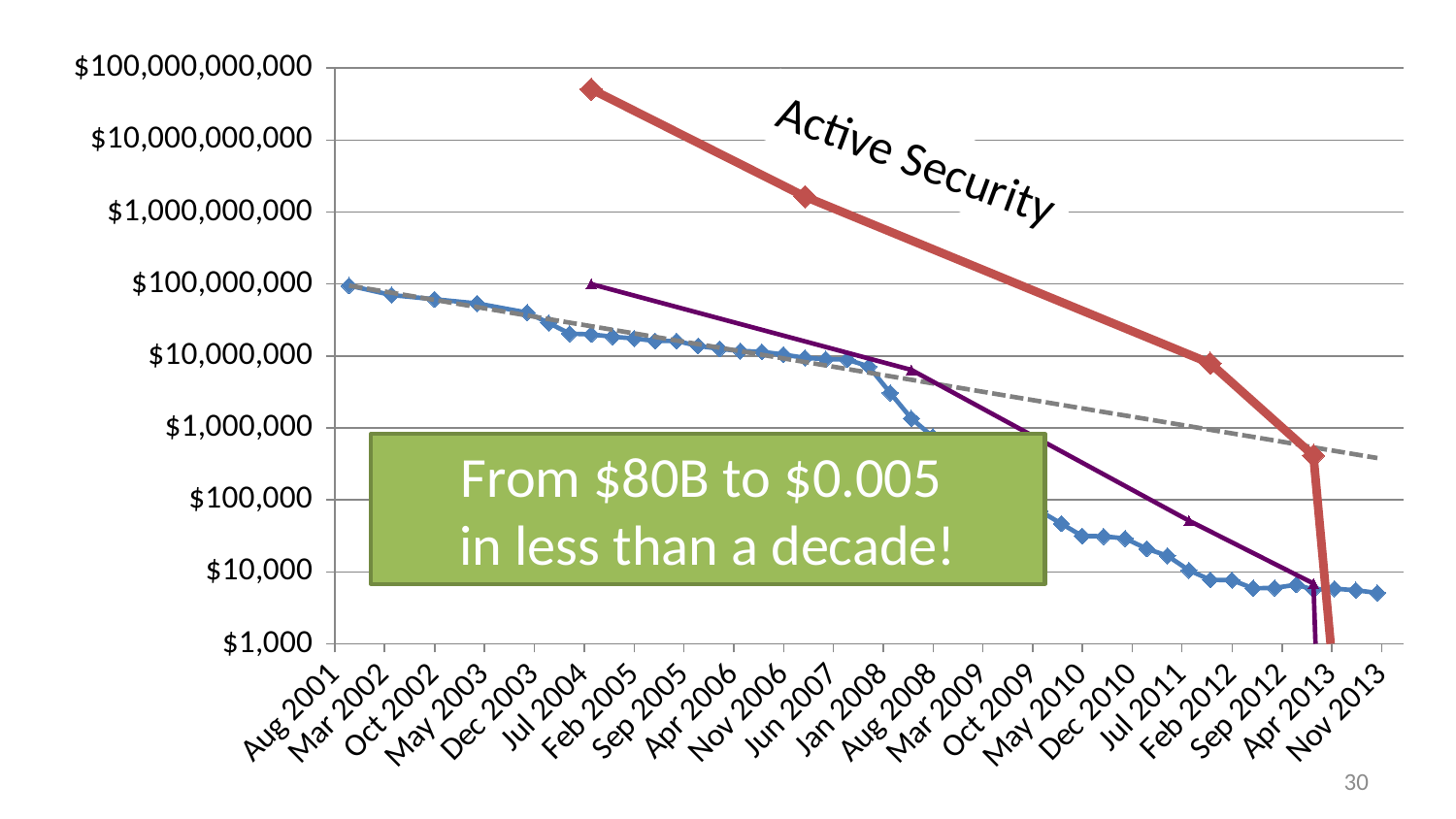
Is the value of the purple triangle-marked line at Jul 2011 greater or less than $100,000? less Which series is labelled directly on the chart? Active Security Is the value of the blue diamond-marked line at Aug 2001 greater or less than $10,000,000? greater Is the value of the blue diamond-marked line at Nov 2013 greater or less than $10,000? less At Feb 2012, which is higher: the Active Security line or the blue diamond-marked line? Active Security What is the highest value labelled on the vertical axis? $100,000,000,000 What kind of chart is shown on the slide? line chart Does the blue diamond-marked line rise or fall from Aug 2001 to Nov 2013? fall What is the first date labelled on the horizontal axis? Aug 2001 Does the Active Security line rise or fall from Jul 2004 to Apr 2013? fall